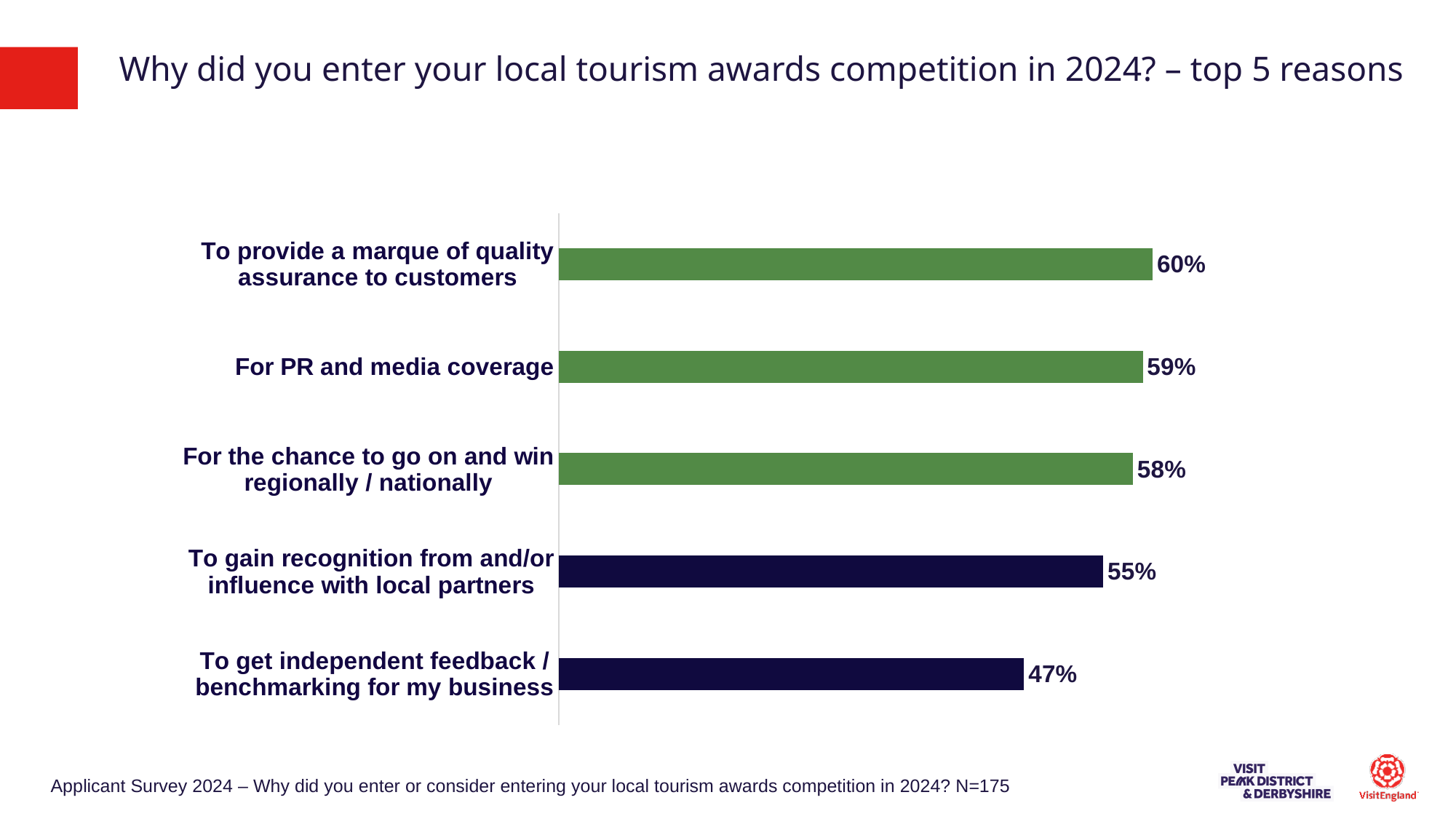
What type of chart is shown on the slide? Bar chart What percentage entered to get independent feedback / benchmarking for my business? 47% What is the value for 'For PR and media coverage'? 59% How many reasons are shown in the chart? 5 What is the difference between the value for 'To provide a marque of quality assurance to customers' and 'To get independent feedback / benchmarking for my business'? 13% How many bars are coloured green? 3 What percentage entered for the chance to go on and win regionally / nationally? 58% What percentage of respondents entered to provide a marque of quality assurance to customers? 60% Which is larger: the value for 'For the chance to go on and win regionally / nationally' or 'To get independent feedback / benchmarking for my business'? For the chance to go on and win regionally / nationally Which reason has the lowest percentage? To get independent feedback / benchmarking for my business What is the value for 'To gain recognition from and/or influence with local partners'? 55% What is the difference between 'For PR and media coverage' and 'To gain recognition from and/or influence with local partners'? 4%